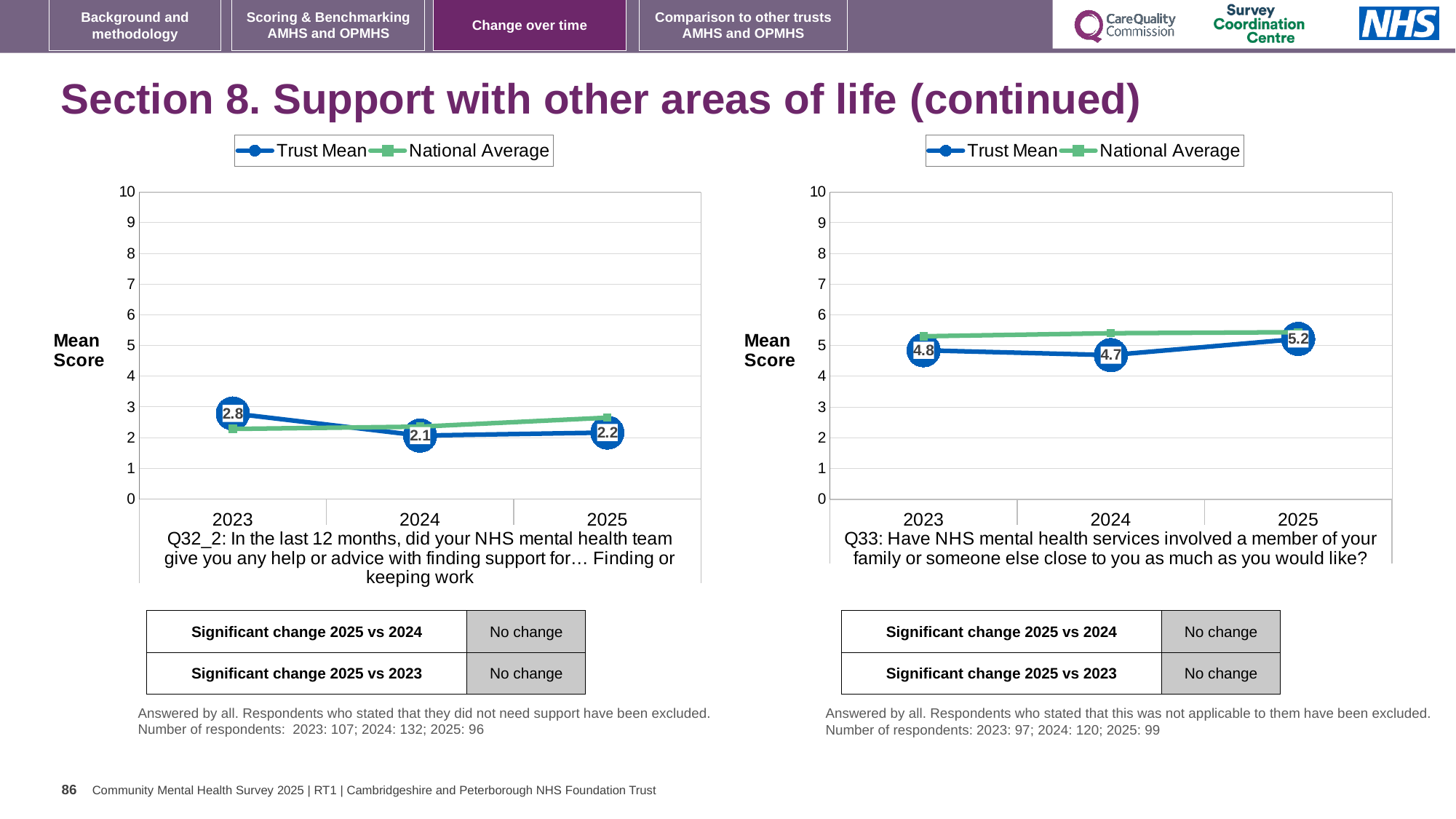
On the right chart (Q33), what is the Trust Mean for 2025? 5.2 What kind of chart is the right chart (Q33)? Line chart On the right chart (Q33), is the Trust Mean for 2025 higher or lower than the Trust Mean for 2023? Higher On the right chart (Q33), what is the difference between the Trust Mean in 2025 and in 2024? 0.5 On the left chart (Q32_2), what is the difference between the Trust Mean in 2023 and in 2024? 0.7 On the left chart (Q32_2), which year has the highest Trust Mean? 2023 How many series does the legend of the left chart list? 2 On the right chart (Q33), which year has the lowest Trust Mean? 2024 On the left chart (Q32_2), what is the Trust Mean for 2023? 2.8 On the right chart (Q33), is the Trust Mean for 2023 greater or less than 5? less On the left chart (Q32_2), what is the Trust Mean for 2025? 2.2 On the right chart (Q33), what is the Trust Mean for 2024? 4.7